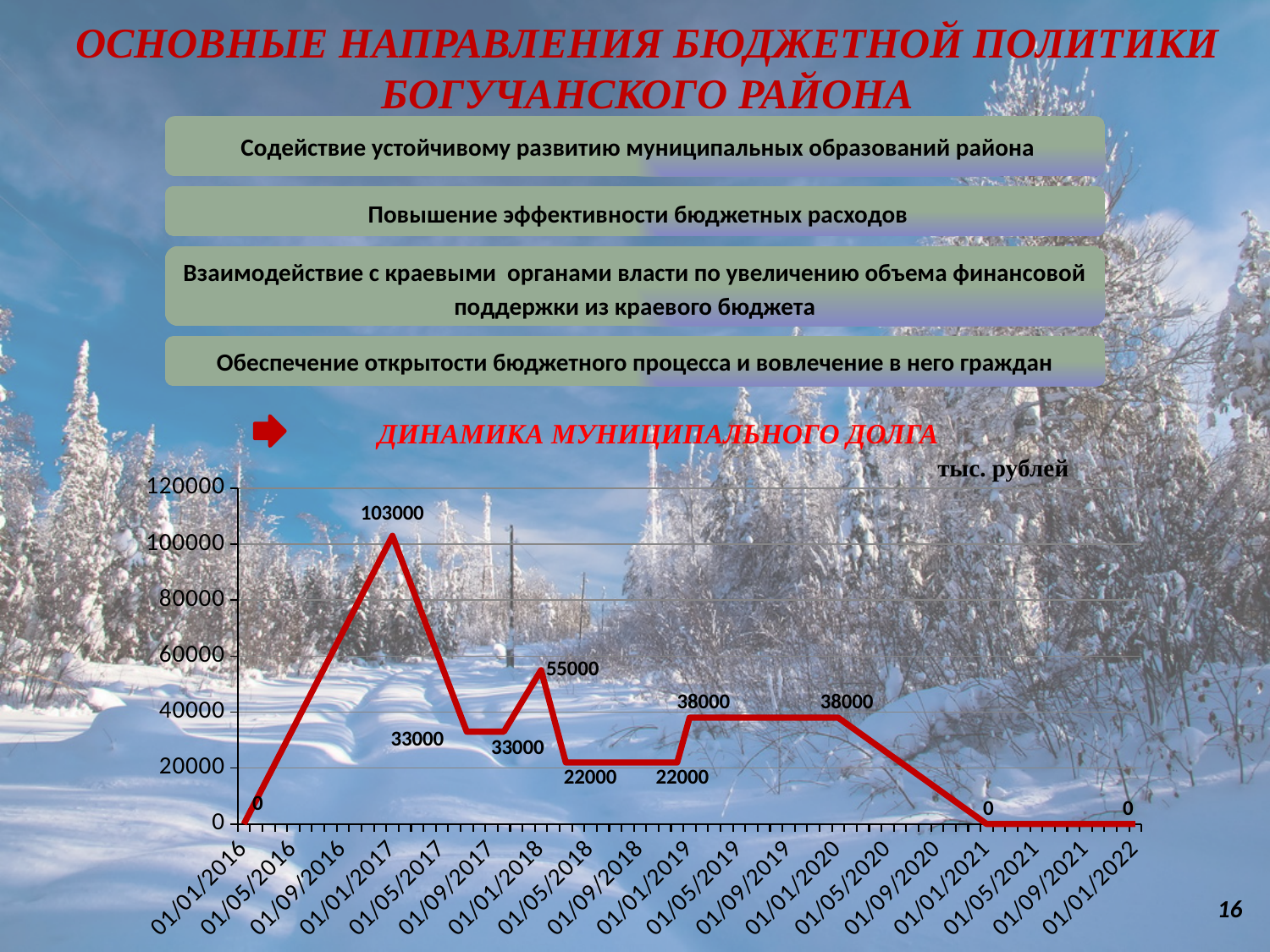
On which date does the municipal debt reach its highest value? 01/01/2017 Is the value on 01/01/2017 greater or less than 100000? greater What is the value of municipal debt on 01/01/2020? 38000 What is the value of municipal debt on 01/01/2018? 55000 What is the difference between the debt on 01/01/2019 and the 22000 level shown before it? 16000 What is the value of municipal debt on 01/01/2017? 103000 Does the municipal debt rise or fall between 01/01/2020 and 01/01/2021? fall Which is larger: the debt on 01/01/2018 or on 01/01/2019? 01/01/2018 What is the difference between the debt on 01/01/2017 and on 01/01/2018? 48000 What kind of chart is used to show the dynamics of municipal debt? line chart What is the value of municipal debt on 01/01/2021? 0 In what units are the values of the municipal debt chart given? тыс. рублей